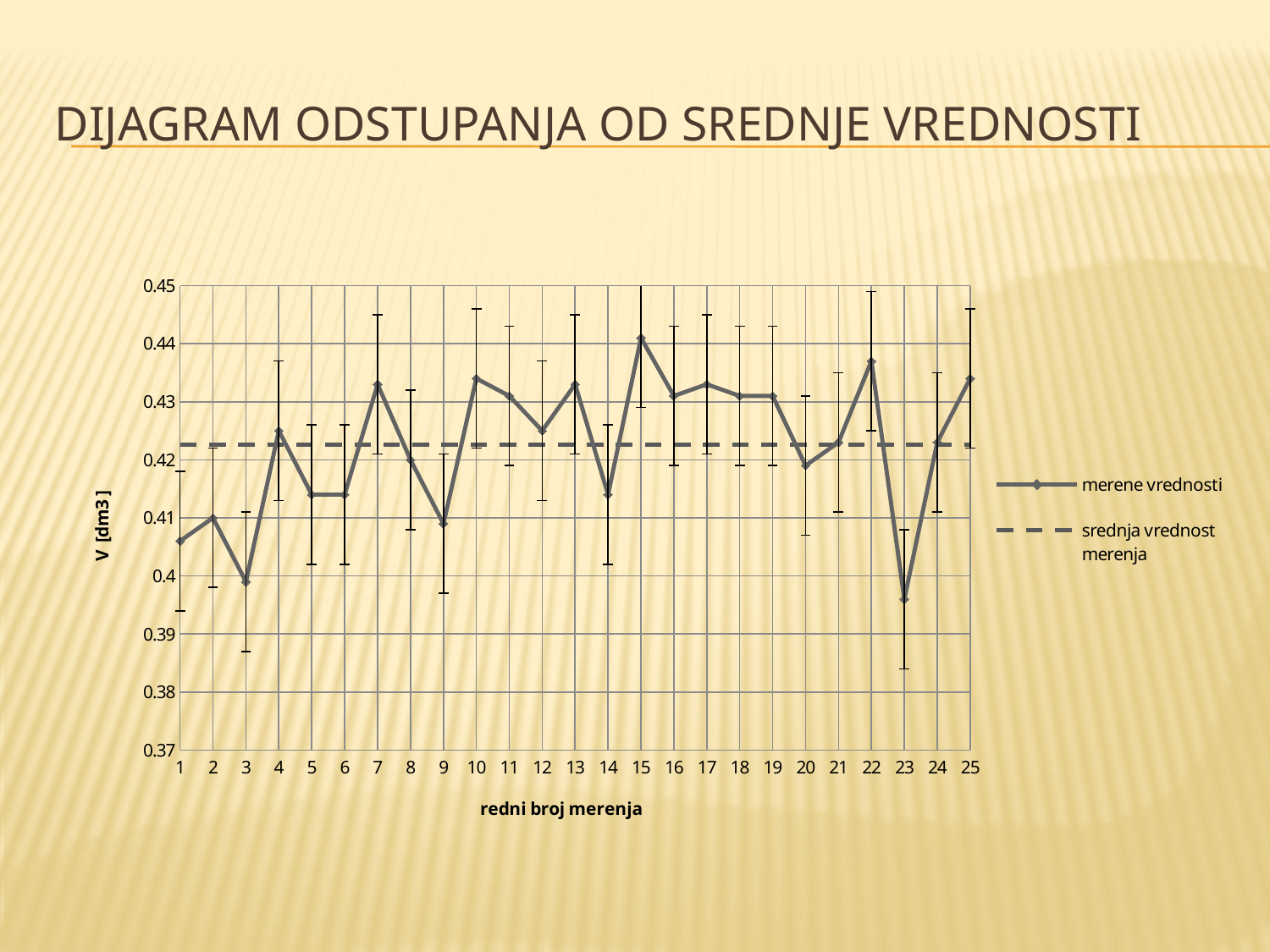
Which is larger, the measured value for measurement 10 or for measurement 9? measurement 10 What kind of chart is shown on the slide? line chart What is the title of the x axis? redni broj merenja Which is larger, the measured value for measurement 4 or for measurement 3? measurement 4 Is the measured value for measurement 22 greater or less than 0.43? greater Which measurement number has the highest value in the 'merene vrednosti' series? 15 Which measurement number has the lowest value in the 'merene vrednosti' series? 23 Is the measured value for measurement 15 greater or less than 0.43? greater Is the measured value for measurement 1 greater or less than 0.41? less How many measurement points are plotted along the x axis? 25 How many series does the legend list? 2